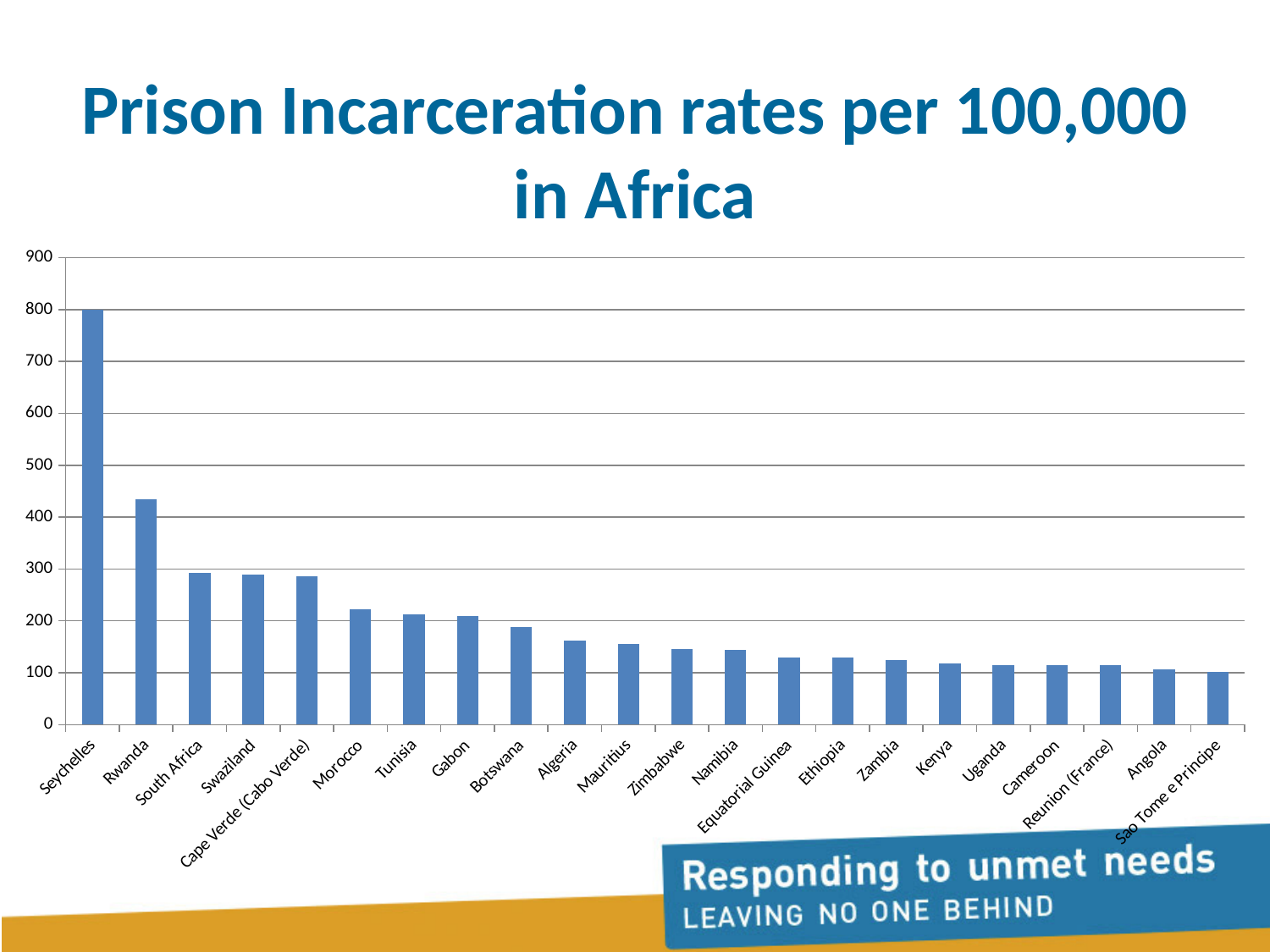
Is the value for Angola greater or less than 200? less Which country has the lowest incarceration rate in the chart? Sao Tome e Principe Which has a higher incarceration rate, Tunisia or Algeria? Tunisia Which country has the highest incarceration rate in the chart? Seychelles What type of chart is shown on the slide? bar chart What is the title of the chart? Prison Incarceration rates per 100,000 in Africa Is the value for Rwanda greater or less than 400? greater Is the value for Morocco greater or less than 200? greater Which has a higher incarceration rate, Rwanda or South Africa? Rwanda Do the values generally rise or fall moving from left to right along the x axis? fall How many countries are shown in the chart? 22